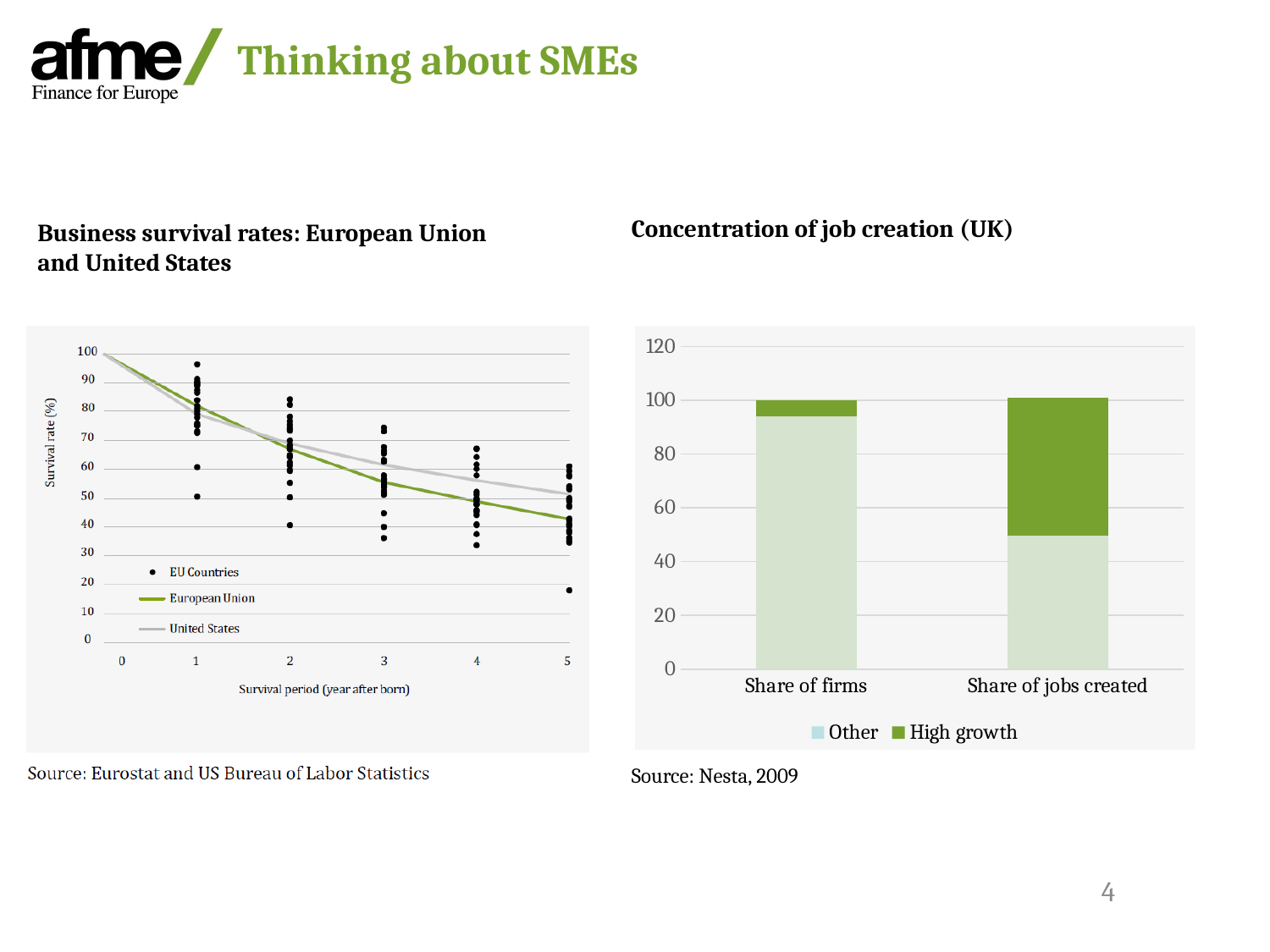
In the 'Concentration of job creation (UK)' chart, is the 'High growth' segment larger for Share of firms or for Share of jobs created? Share of jobs created In the 'Business survival rates' chart, is the European Union survival rate at year 5 greater or less than 50? less How many categories are shown on the x axis of the 'Concentration of job creation (UK)' chart? 2 In the 'Business survival rates' chart, do the European Union and United States lines rise or fall as the survival period increases? fall In the 'Concentration of job creation (UK)' chart, is the 'Other' value for Share of firms greater or less than 80? greater What kind of chart is the 'Concentration of job creation (UK)' chart? bar chart In the 'Concentration of job creation (UK)' chart, is the 'Other' segment larger for Share of firms or for Share of jobs created? Share of firms What are the two legend entries in the 'Concentration of job creation (UK)' chart? Other, High growth What is the x-axis label of the 'Business survival rates' chart? Survival period (year after born) In the 'Business survival rates' chart, at year 5, which line is higher: European Union or United States? United States How many series does the legend of the 'Concentration of job creation (UK)' chart list? 2 How many series does the legend of the 'Business survival rates' chart list? 3